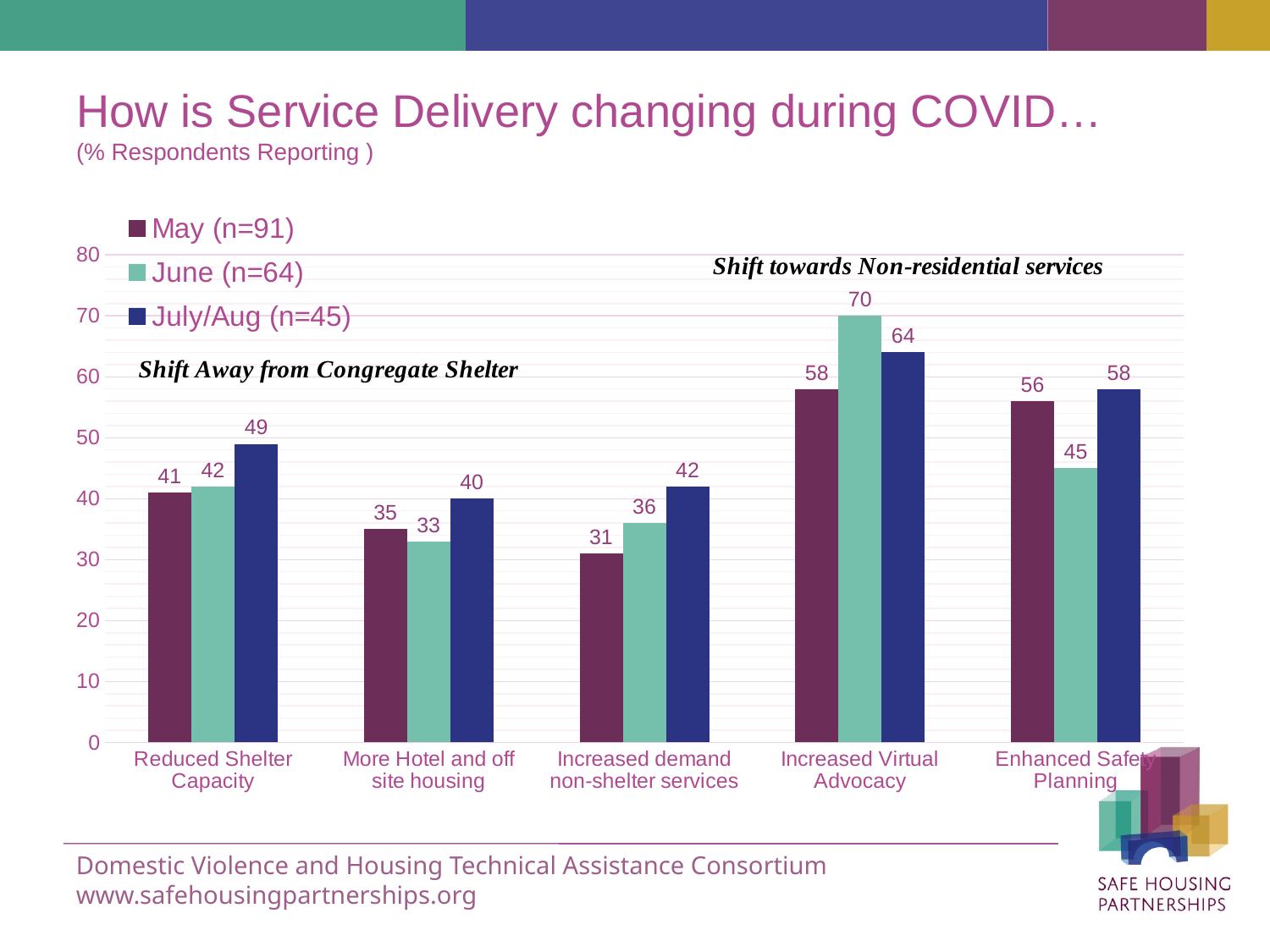
How many categories are shown on the x axis? 5 How many series does the legend list? 3 Which is larger for Enhanced Safety Planning: the May (n=91) value or the June (n=64) value? May (n=91) What is the July/Aug (n=45) value for Enhanced Safety Planning? 58 Which category has the lowest May (n=91) value? Increased demand non-shelter services What is the June (n=64) value for Increased Virtual Advocacy? 70 Do the values for Increased demand non-shelter services rise or fall from May to July/Aug? Rise What is the May (n=91) value for Reduced Shelter Capacity? 41 What is the difference between the June (n=64) and May (n=91) values for Increased Virtual Advocacy? 12 Which category has the highest July/Aug (n=45) value? Increased Virtual Advocacy What kind of chart is shown on the slide? Bar chart What is the June (n=64) value for More Hotel and off site housing? 33